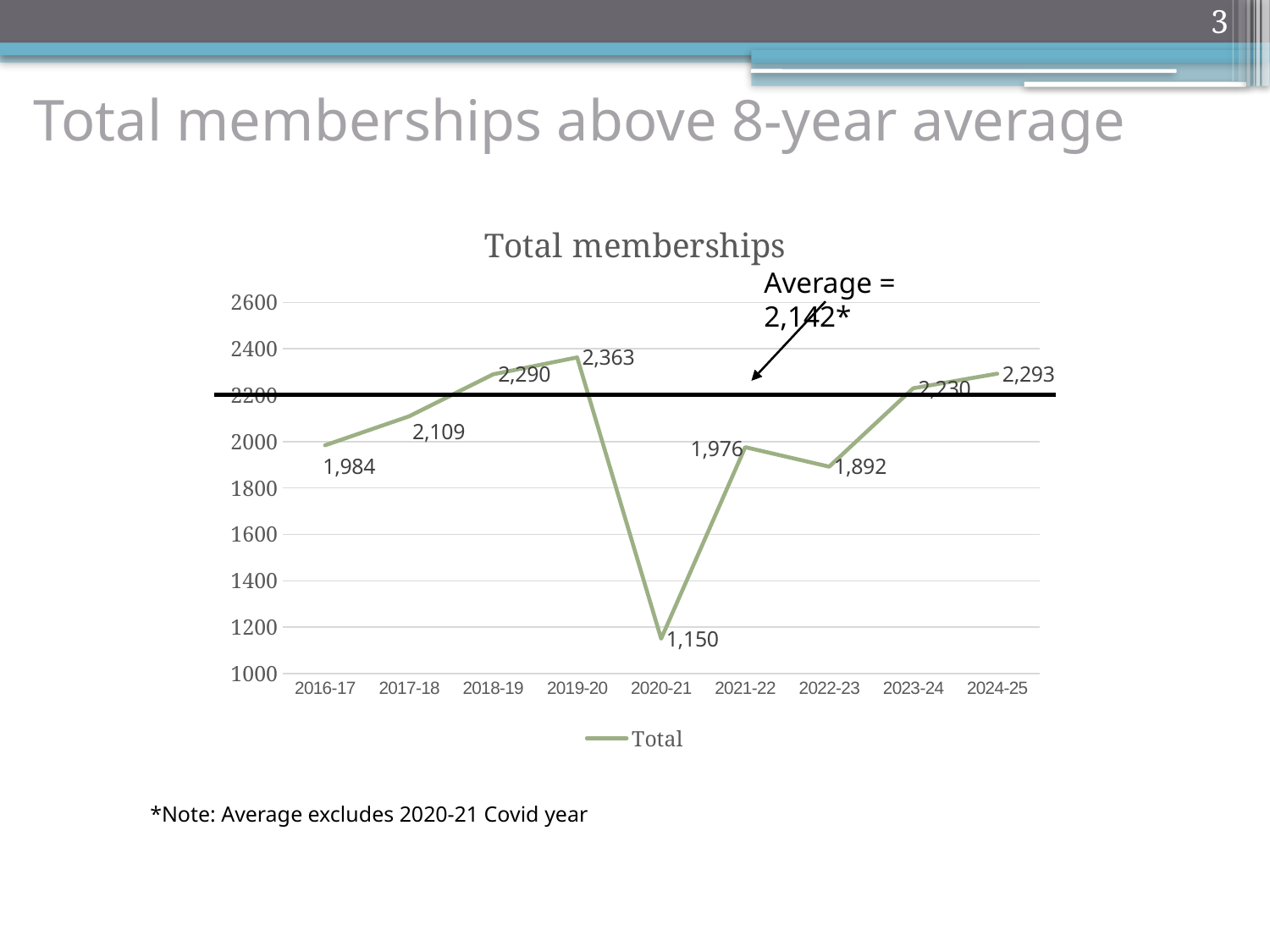
What is the difference between total memberships in 2024-25 and 2016-17? 309 Which year has the lowest total memberships? 2020-21 Is the value for 2017-18 greater or less than 2200? less What kind of chart is the Total memberships chart? line chart What is the value for 2019-20 in the Total memberships chart? 2,363 What is the value for 2020-21 in the Total memberships chart? 1,150 Which year has the highest total memberships? 2019-20 What is the difference between total memberships in 2019-20 and 2020-21? 1,213 Which year has more total memberships, 2021-22 or 2022-23? 2021-22 What average value is marked by the horizontal line on the chart? 2,142 What is the value for 2024-25 in the Total memberships chart? 2,293 How many years are plotted on the x axis of the Total memberships chart? 9